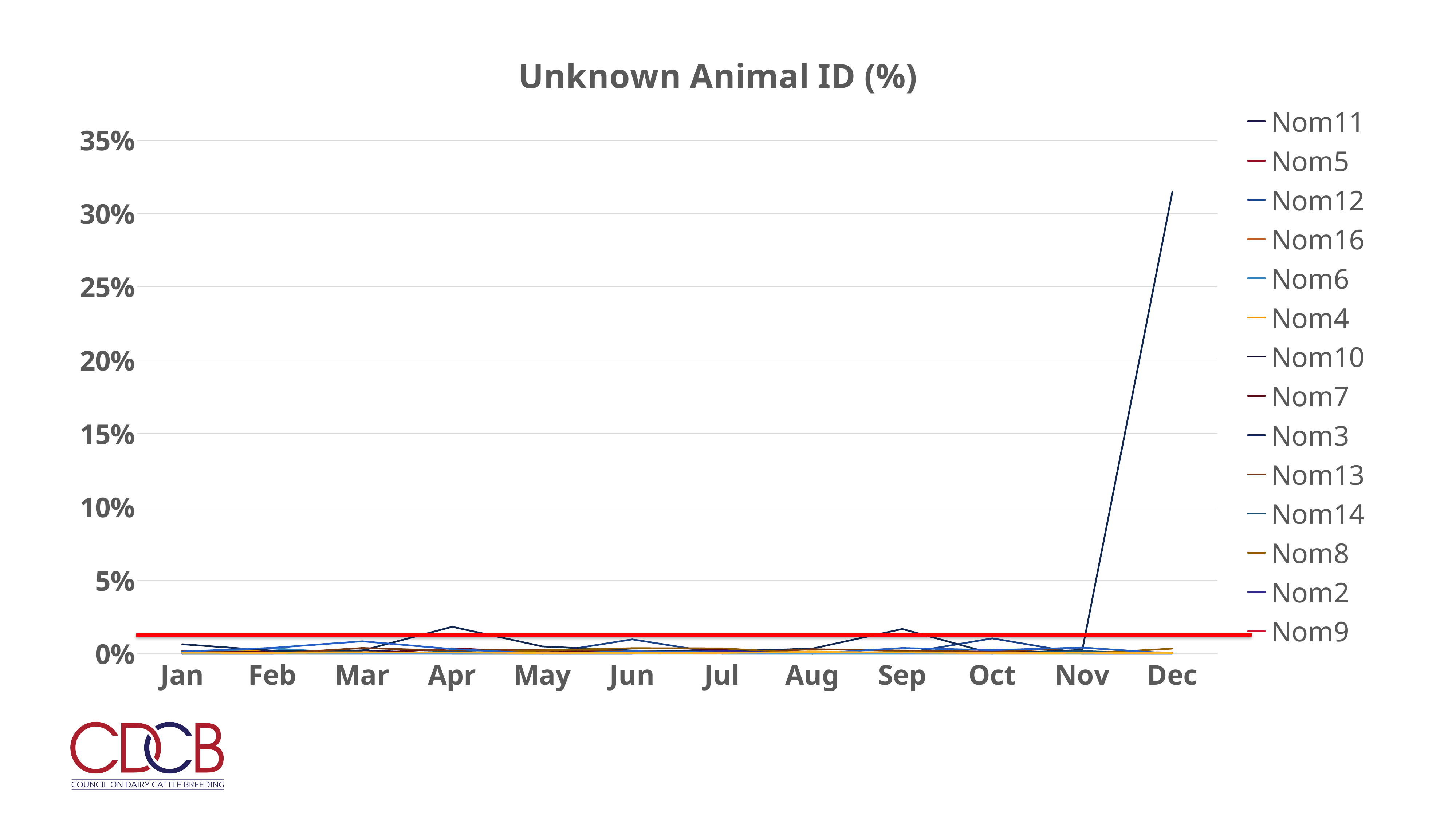
What is the title of the chart? Unknown Animal ID (%) What kind of chart is shown on the slide? line chart In which month does the chart reach its highest value? Dec In Nov, are all the plotted values greater or less than 5%? less Is the value of the Nom9 line greater or less than 5%? less How many months are shown along the x axis? 12 Does the Nom9 line rise, fall, or stay flat from Jan to Dec? stays flat Is the peak value reached in Dec greater or less than 35%? less How many series does the legend list? 14